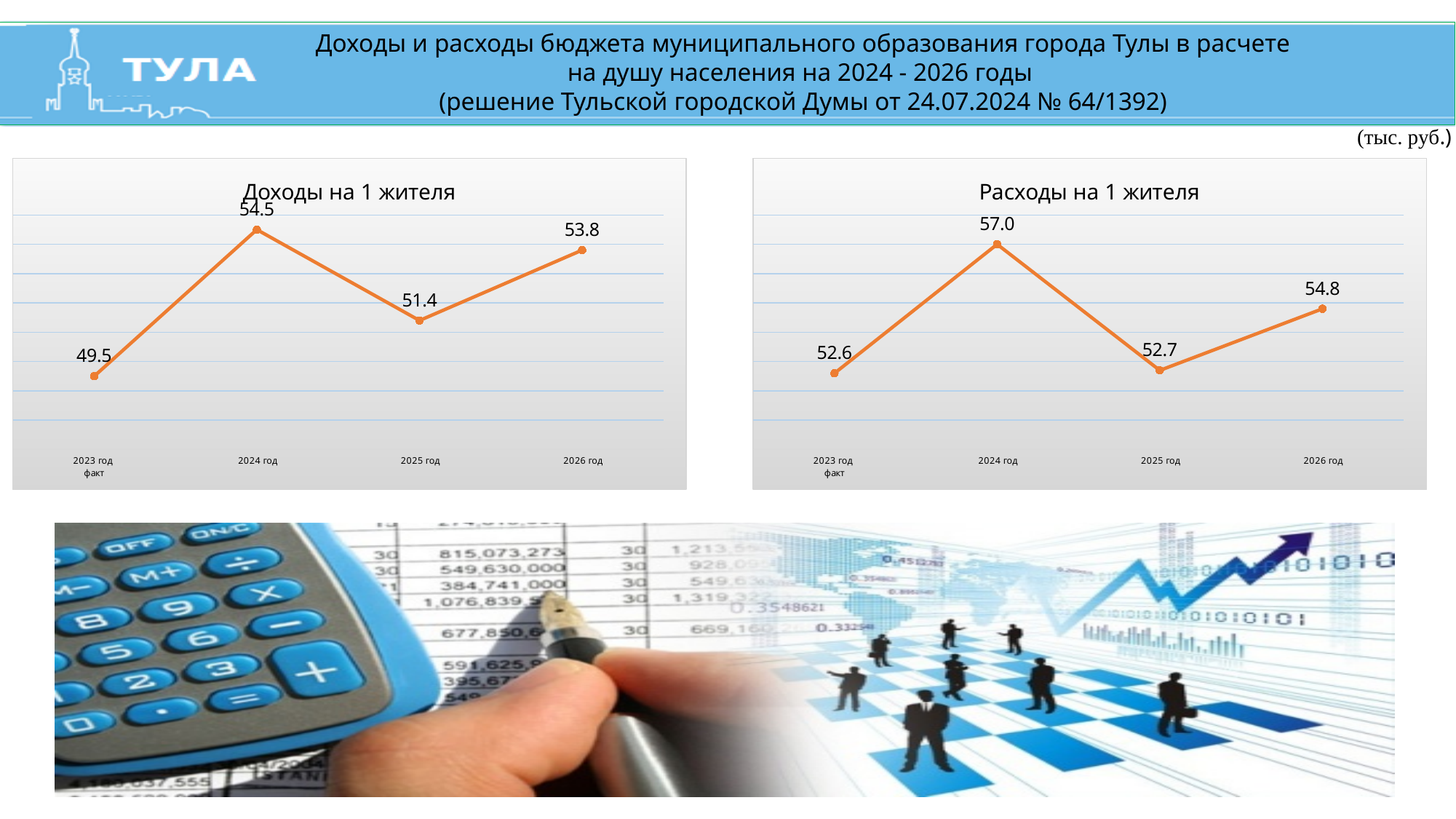
In the 'Доходы на 1 жителя' chart, what is the difference between the 2024 год and 2025 год values? 3.1 What unit is indicated for the values on the slide? тыс. руб. In the 'Расходы на 1 жителя' chart, does the value rise or fall from 2024 год to 2025 год? Fall In the 'Доходы на 1 жителя' chart, which year has the lowest value? 2023 год факт In the 'Расходы на 1 жителя' chart, which is larger: the value for 2025 год or 2026 год? 2026 год In the 'Расходы на 1 жителя' chart, which year has the highest value? 2024 год In the 'Расходы на 1 жителя' chart, what is the difference between the 2024 год and 2023 год факт values? 4.4 What type of chart is 'Расходы на 1 жителя'? Line chart In the 'Расходы на 1 жителя' chart, what is the value for 2026 год? 54.8 In the 'Доходы на 1 жителя' chart, does the value rise or fall from 2025 год to 2026 год? Rise In the 'Доходы на 1 жителя' chart, what is the value for 2024 год? 54.5 In the 'Доходы на 1 жителя' chart, how many data points are plotted? 4